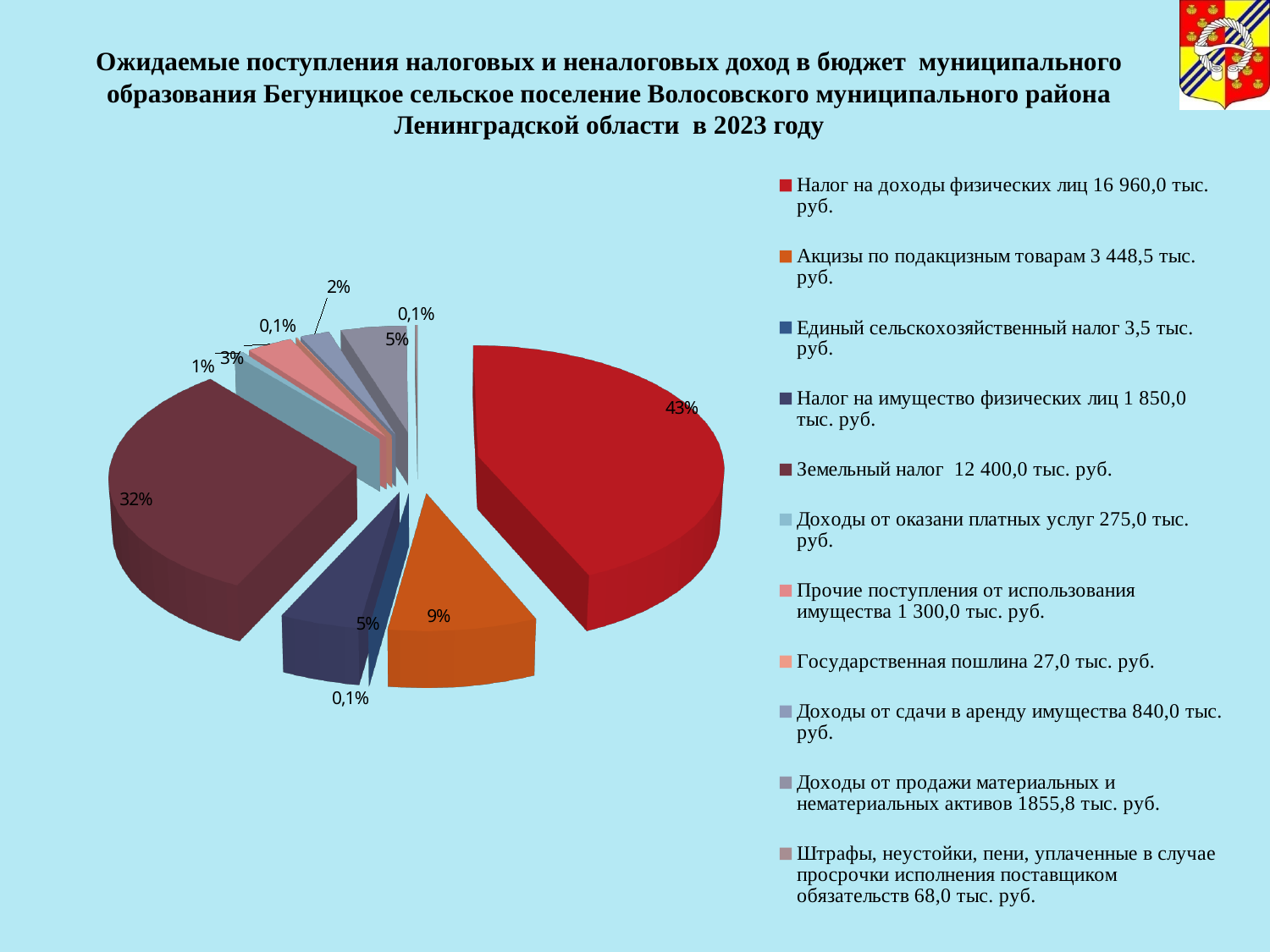
Which is larger: the expected amount for 'Акцизы по подакцизным товарам' or for 'Налог на имущество физических лиц'? Акцизы по подакцизным товарам What share of the pie does 'Земельный налог' take? 32% Which revenue source has the largest expected amount? Налог на доходы физических лиц What is the expected amount for 'Государственная пошлина' according to the legend? 27,0 тыс. руб. What share of the pie does 'Акцизы по подакцизным товарам' take? 9% What is the difference between the expected amounts for 'Налог на доходы физических лиц' and 'Земельный налог'? 4 560,0 тыс. руб. What is the expected amount for 'Доходы от сдачи в аренду имущества' according to the legend? 840,0 тыс. руб. How many categories does the legend of the pie chart list? 11 Which revenue source has the smallest expected amount? Единый сельскохозяйственный налог What share of the pie does 'Налог на доходы физических лиц' take? 43% What kind of chart is shown on the slide? Pie chart What is the expected amount for 'Земельный налог' according to the legend? 12 400,0 тыс. руб.